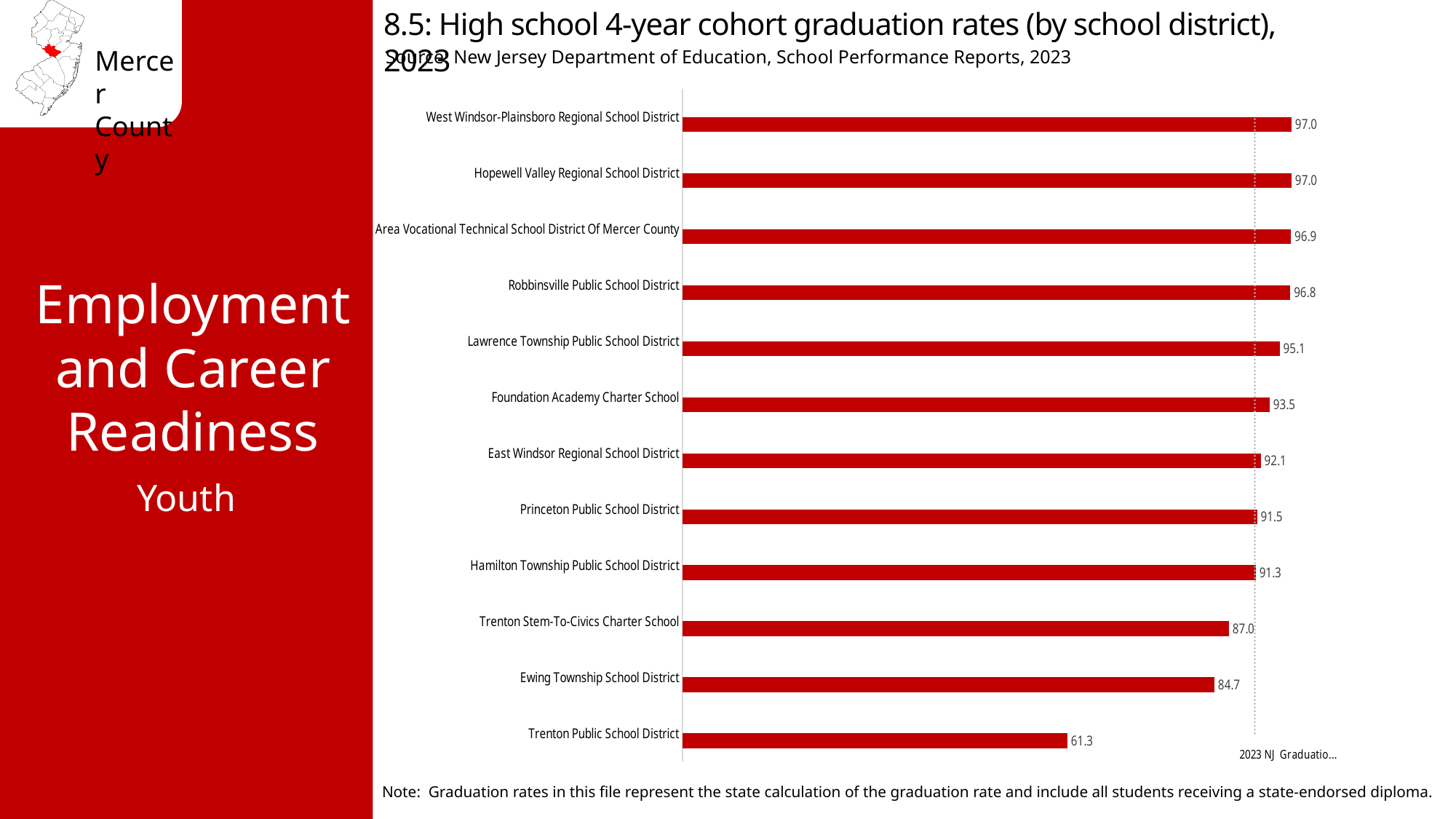
What is the difference between the graduation rates of Lawrence Township Public School District and Princeton Public School District? 3.6 Which has a higher graduation rate, Ewing Township School District or Trenton Stem-To-Civics Charter School? Trenton Stem-To-Civics Charter School What is the 4-year cohort graduation rate for Trenton Public School District? 61.3 Which has a higher graduation rate, Foundation Academy Charter School or Hamilton Township Public School District? Foundation Academy Charter School What type of chart is used to show the graduation rates? Bar chart Which school district has the lowest graduation rate on the chart? Trenton Public School District What is the graduation rate shown for Ewing Township School District? 84.7 How many school districts are shown on the chart? 12 What is the difference between the graduation rates of Trenton Stem-To-Civics Charter School and Trenton Public School District? 25.7 What is the graduation rate shown for Lawrence Township Public School District? 95.1 What is the graduation rate shown for Robbinsville Public School District? 96.8 What colour are the bars in the chart? Red